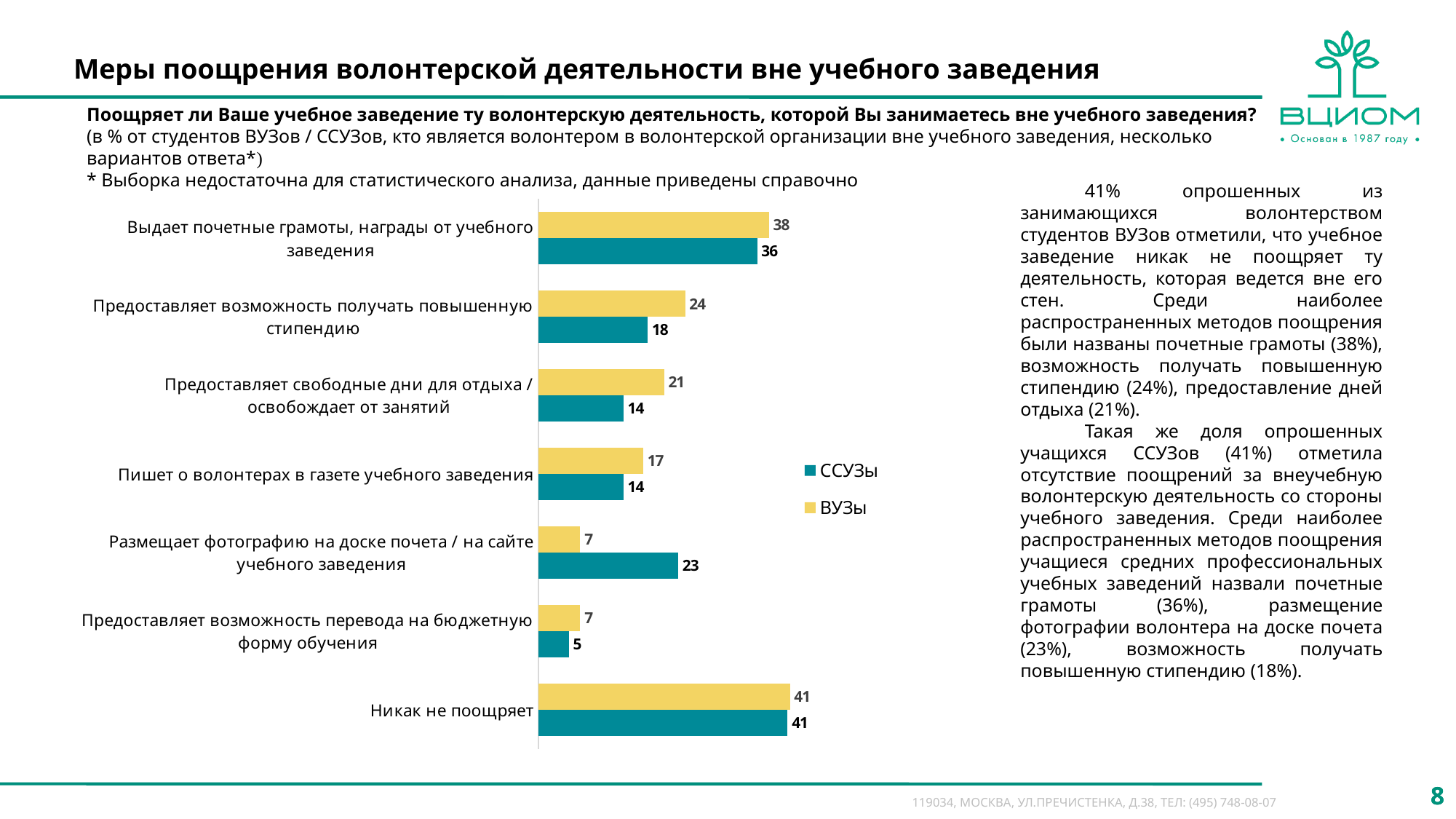
What kind of chart is shown on the slide? Bar chart What is the value for ССУЗы for «Размещает фотографию на доске почета / на сайте учебного заведения»? 23 What is the value for ВУЗы for «Выдает почетные грамоты, награды от учебного заведения»? 38 Which colour represents the ССУЗы series in the chart? Teal How many categories are shown in the chart? 7 For «Предоставляет свободные дни для отдыха / освобождает от занятий», which series has the larger value, ВУЗы or ССУЗы? ВУЗы How many series does the legend list? 2 Which category has the highest value for ВУЗы? Никак не поощряет For «Размещает фотографию на доске почета / на сайте учебного заведения», which series has the larger value, ВУЗы or ССУЗы? ССУЗы Which category has the lowest value for ССУЗы? Предоставляет возможность перевода на бюджетную форму обучения What is the value for ССУЗы for «Предоставляет возможность перевода на бюджетную форму обучения»? 5 What is the difference between the ВУЗы and ССУЗы values for «Предоставляет возможность получать повышенную стипендию»? 6